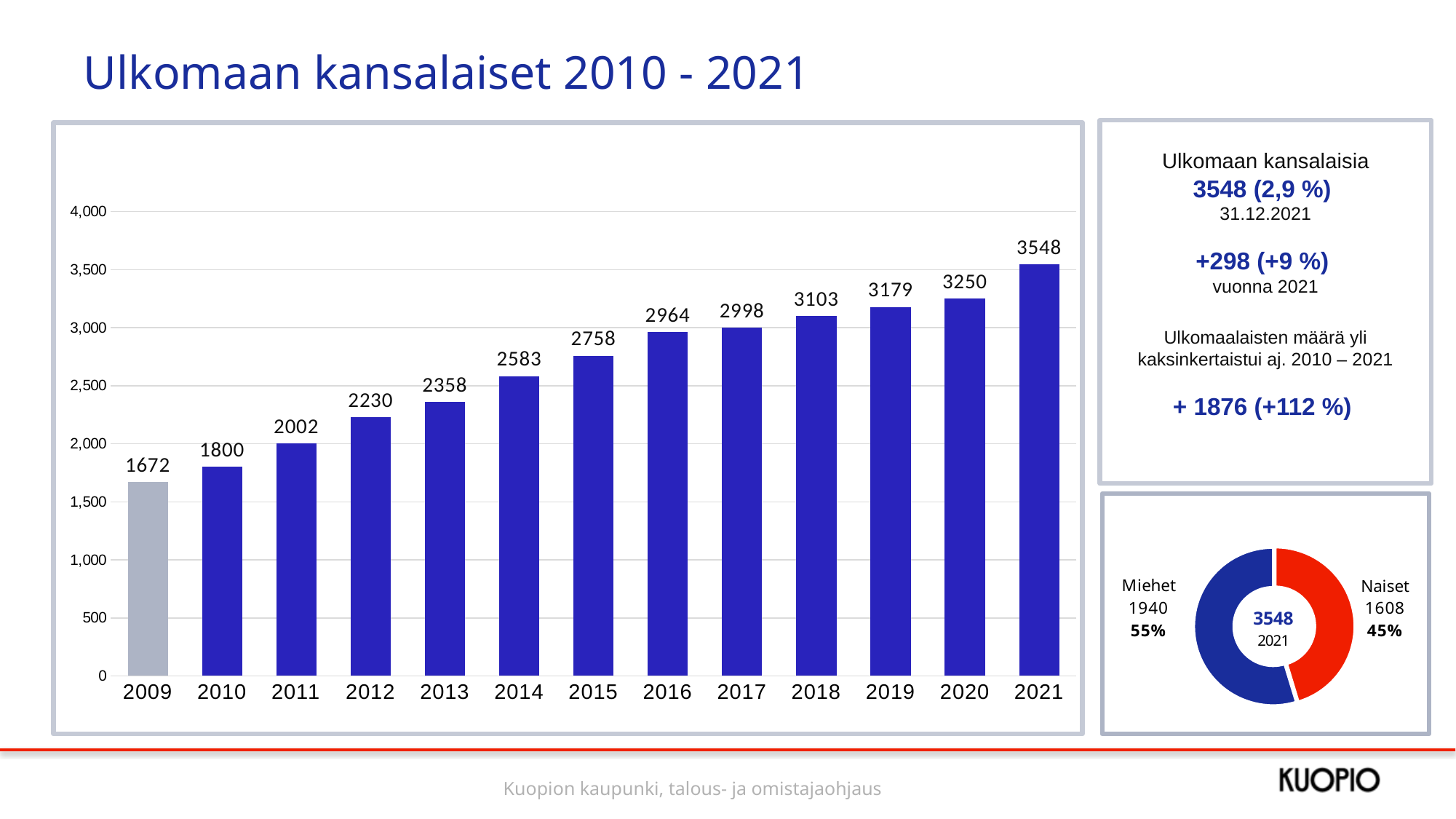
In the bar chart on the left, which is larger, the value for 2013 or the value for 2014? 2014 In the donut chart at the bottom right, what is the value for Miehet? 1940 In the bar chart on the left, which year has the highest value? 2021 In the bar chart on the left, what is the value for 2015? 2758 In the bar chart on the left, is the value for 2018 greater or less than 3,000? greater In the bar chart on the left, what is the difference between the values for 2021 and 2020? 298 In the donut chart at the bottom right, what share does Naiset have? 45% In the bar chart on the left, what is the value for 2009? 1672 How many years are shown on the x axis of the bar chart on the left? 13 What kind of chart is the chart on the left of the slide? bar chart In the bar chart on the left, which year has the lowest value? 2009 In the bar chart on the left, do the values rise or fall from 2009 to 2021? rise